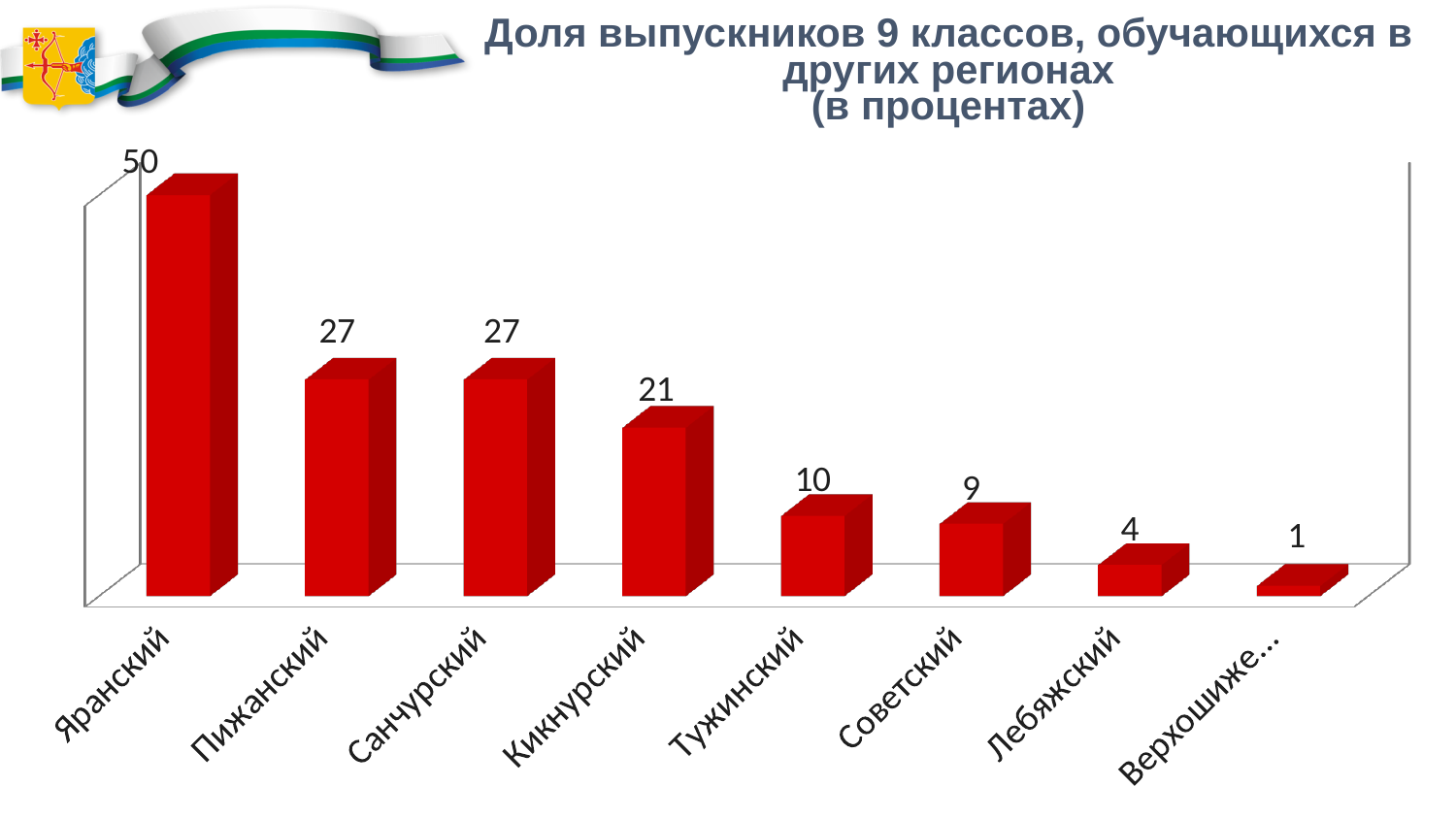
What kind of chart is shown on the slide? Bar chart What is the value for Кикнурский? 21 What is the value for Тужинский? 10 What is the value for Лебяжский? 4 What colour are the bars in the chart? Red What is the difference between the values for Кикнурский and Советский? 12 Which is larger, the value for Тужинский or the value for Советский? Тужинский What is the difference between the values for Яранский and Пижанский? 23 What is the value for Яранский? 50 Do the values rise or fall from left to right along the x axis? Fall How many categories are shown in the chart? 8 Which category has the highest value? Яранский